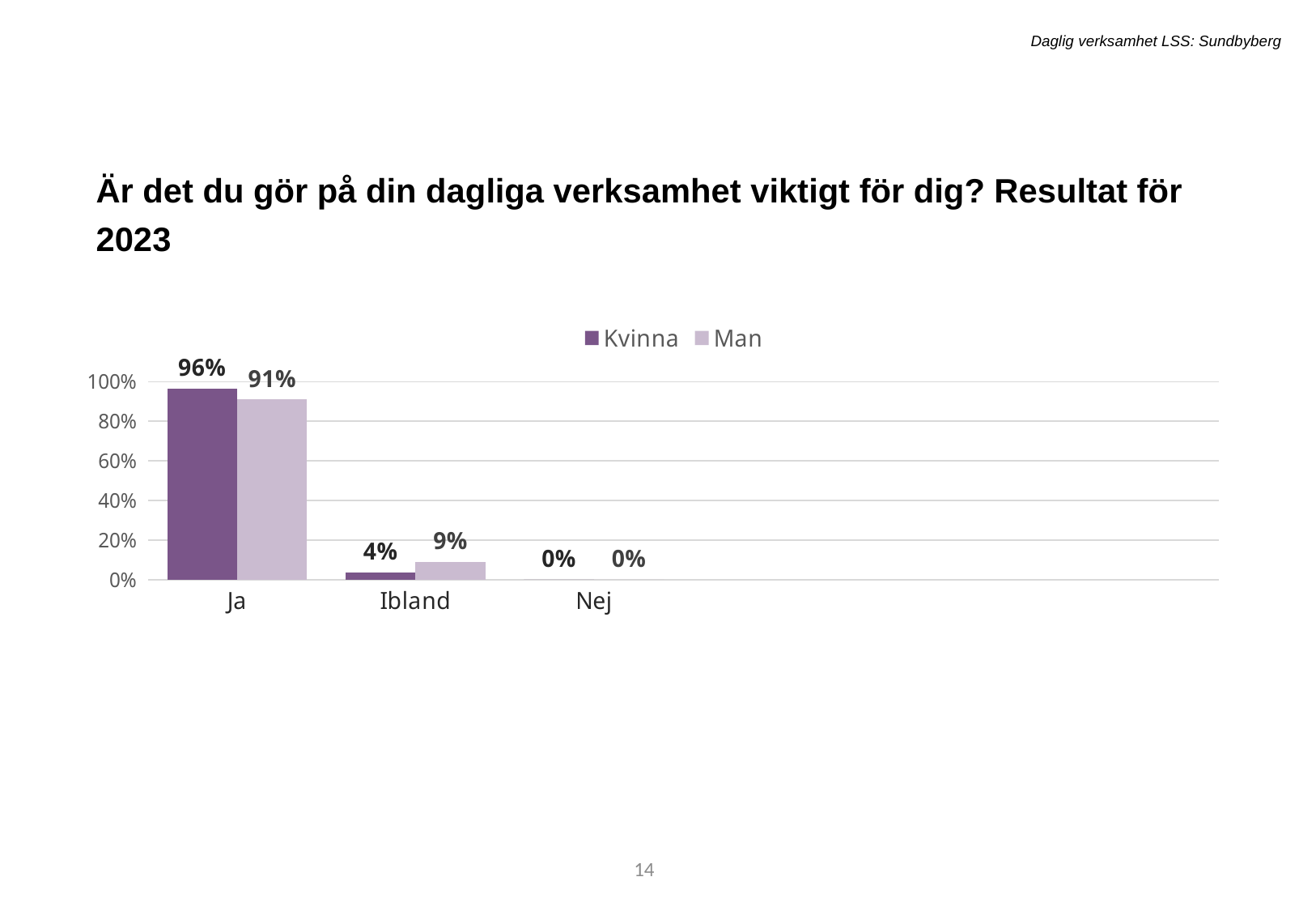
How many series does the legend list? 2 What is the value for Man in the Ja category? 91% What is the value for Kvinna in the Nej category? 0% What kind of chart is shown on the slide? Bar chart What is the difference between the Kvinna and Man values in the Ja category? 5% What is the value for Kvinna in the Ja category? 96% Which category has the highest value for Kvinna? Ja What is the value for Man in the Ibland category? 9% What is the value for Kvinna in the Ibland category? 4% In the Ibland category, which series has the larger value, Kvinna or Man? Man Which category has the lowest value for Man? Nej How many categories are shown on the x axis? 3